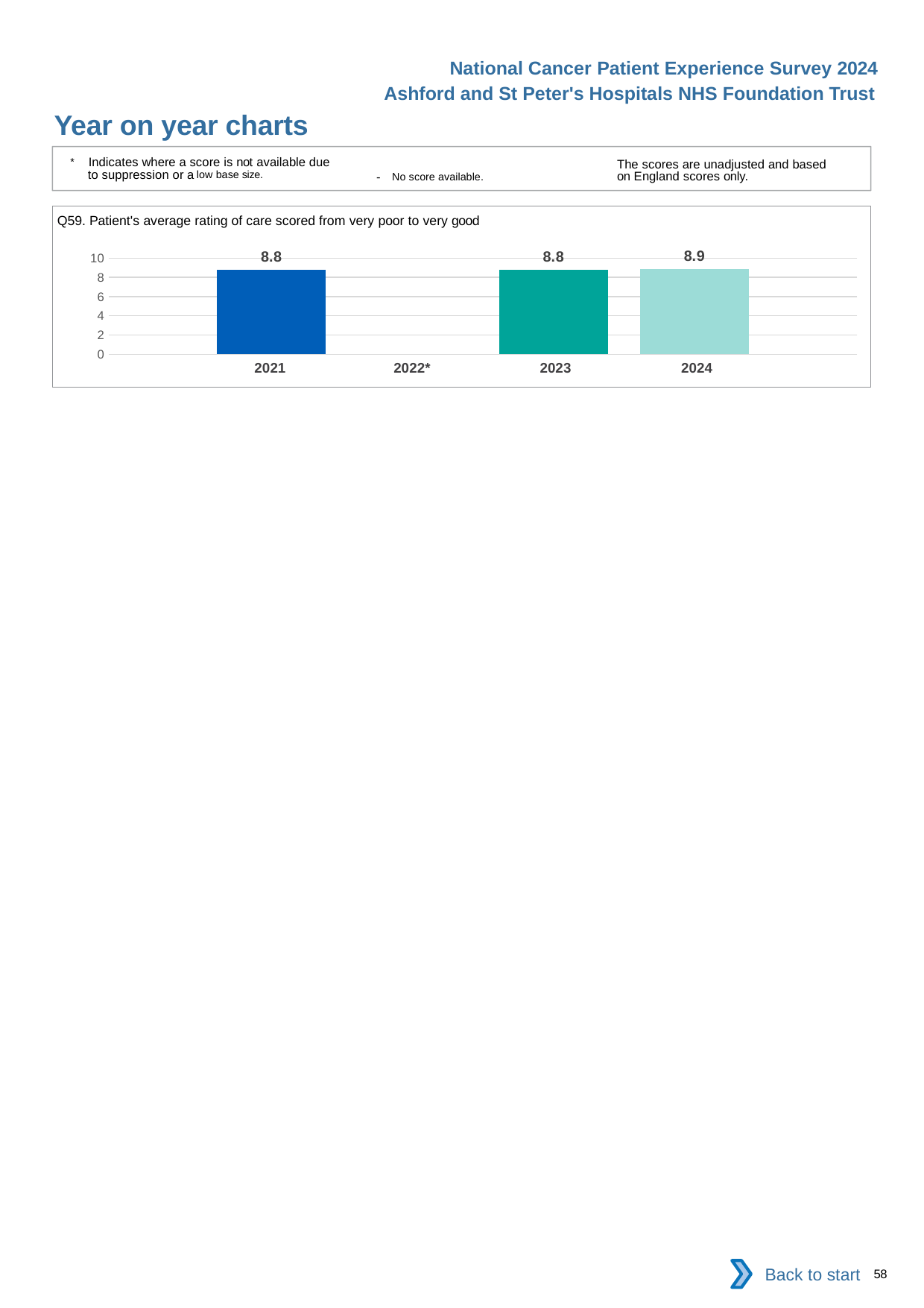
Which year has no bar plotted? 2022* Is the value for 2023 greater or less than 6? greater How many years have a bar plotted? 3 How many years are shown on the x axis? 4 What is the value for 2021? 8.8 Which year has the highest value? 2024 What is the title of the chart? Q59. Patient's average rating of care scored from very poor to very good What is the value for 2023? 8.8 What kind of chart is this? Bar chart What is the value for 2024? 8.9 Is the value for 2024 larger than the value for 2021? Yes What is the difference between the values for 2024 and 2023? 0.1